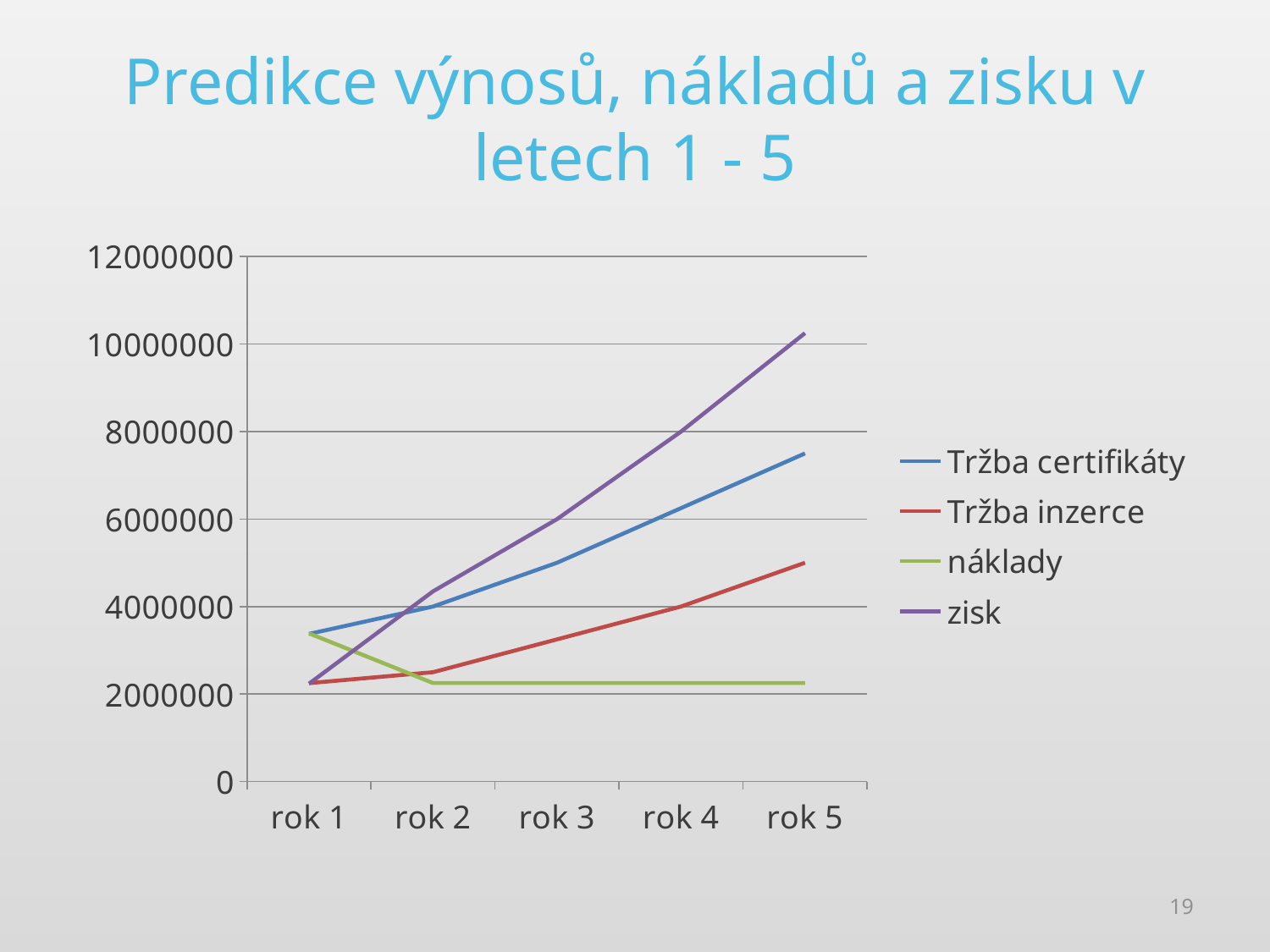
Does the zisk line rise or fall from rok 1 to rok 5? rise What is the title of the chart slide? Predikce výnosů, nákladů a zisku v letech 1 - 5 What kind of chart is shown on the slide? line chart Is the value of zisk in rok 5 greater or less than 10000000? greater How many series does the legend list? 4 In rok 1, which is larger: náklady or Tržba inzerce? náklady Which series has the lowest value in rok 5? náklady Is the value of Tržba inzerce in rok 5 greater or less than 6000000? less How many years (categories) are shown on the x axis? 5 Which series has the highest value in rok 5? zisk Is the value of Tržba certifikáty in rok 5 greater or less than 8000000? less In rok 5, which is larger: Tržba certifikáty or Tržba inzerce? Tržba certifikáty